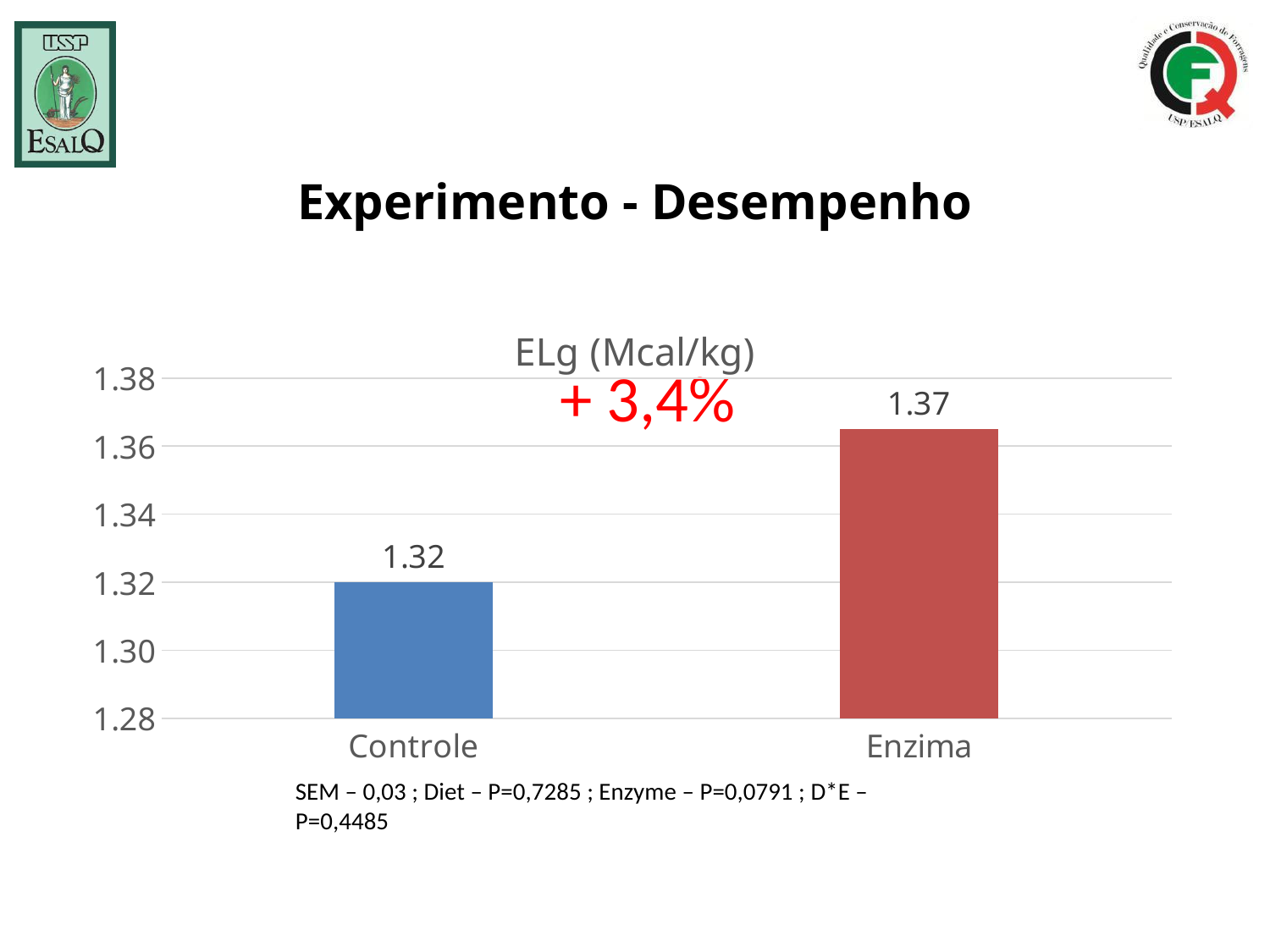
How many categories are shown in the chart? 2 Is the value for Controle greater or less than 1.34? less Which category has the highest value? Enzima What percentage change is annotated in red on the chart? + 3,4% Is the value for Enzima greater or less than 1.36? greater What kind of chart is shown on the slide? bar chart What is the value for Controle? 1.32 What is the title of the chart? ELg (Mcal/kg) What is the value for Enzima? 1.37 Which category has the lowest value? Controle Which is larger, the value for Controle or the value for Enzima? Enzima What is the difference between the values for Enzima and Controle? 0.05